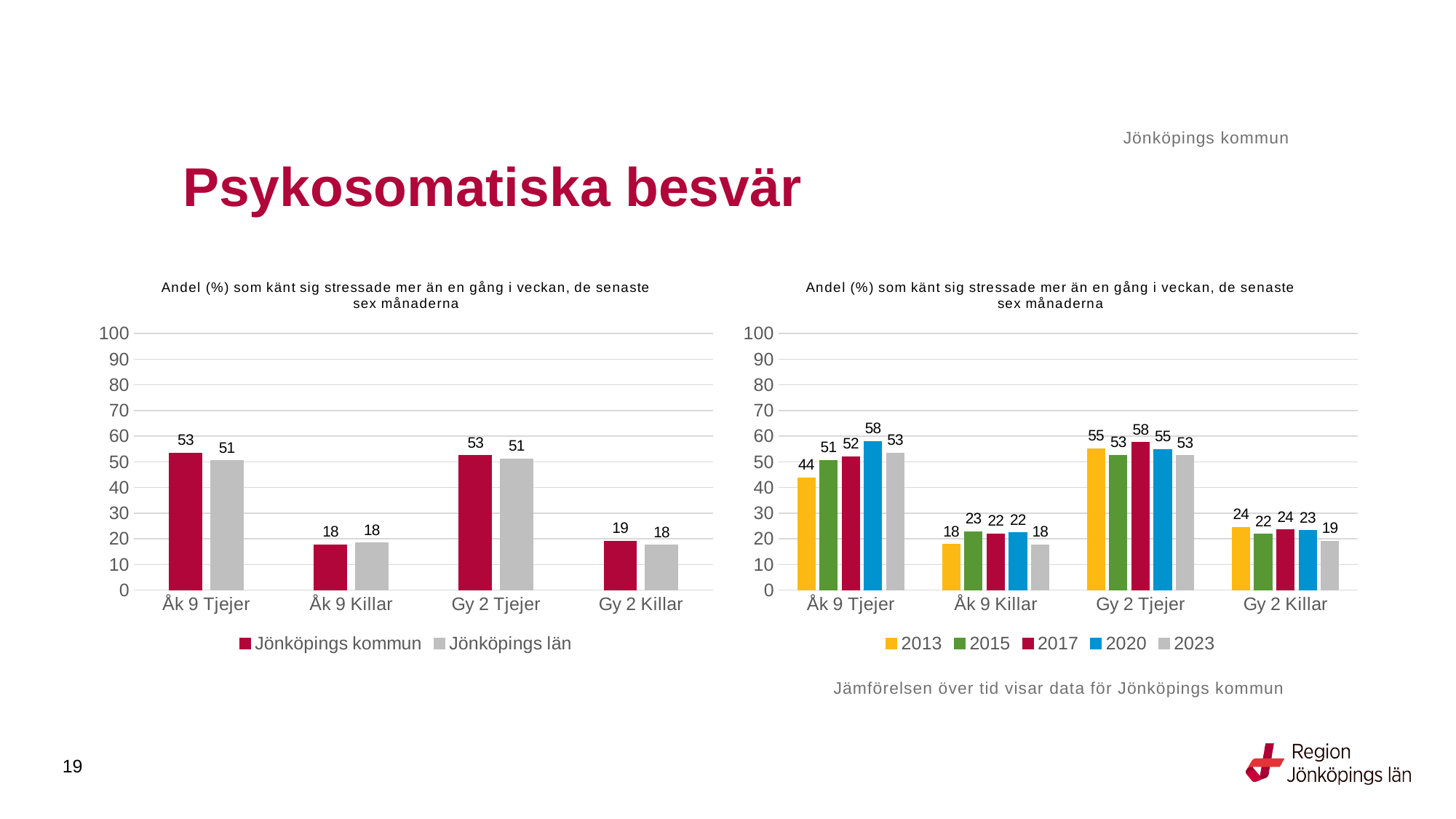
In the left chart, what is the value for Jönköpings kommun for Åk 9 Tjejer? 53 In the right chart, what is the value for 2013 for Åk 9 Tjejer? 44 In the right chart, what is the value for 2020 for Gy 2 Killar? 23 In the left chart, what is the difference between Jönköpings kommun and Jönköpings län for Gy 2 Tjejer? 2 In the right chart, is the 2017 value for Gy 2 Tjejer larger or smaller than the 2023 value? larger What kind of chart is the right chart? bar chart In the left chart, which category has the lowest value for Jönköpings kommun? Åk 9 Killar In the left chart, what is the value for Jönköpings län for Gy 2 Killar? 18 In the right chart, which year has the highest value for Åk 9 Tjejer? 2020 In the right chart, how many series does the legend list? 5 In the right chart, what is the difference between the 2020 and 2013 values for Åk 9 Tjejer? 14 In the left chart, how many series does the legend list? 2